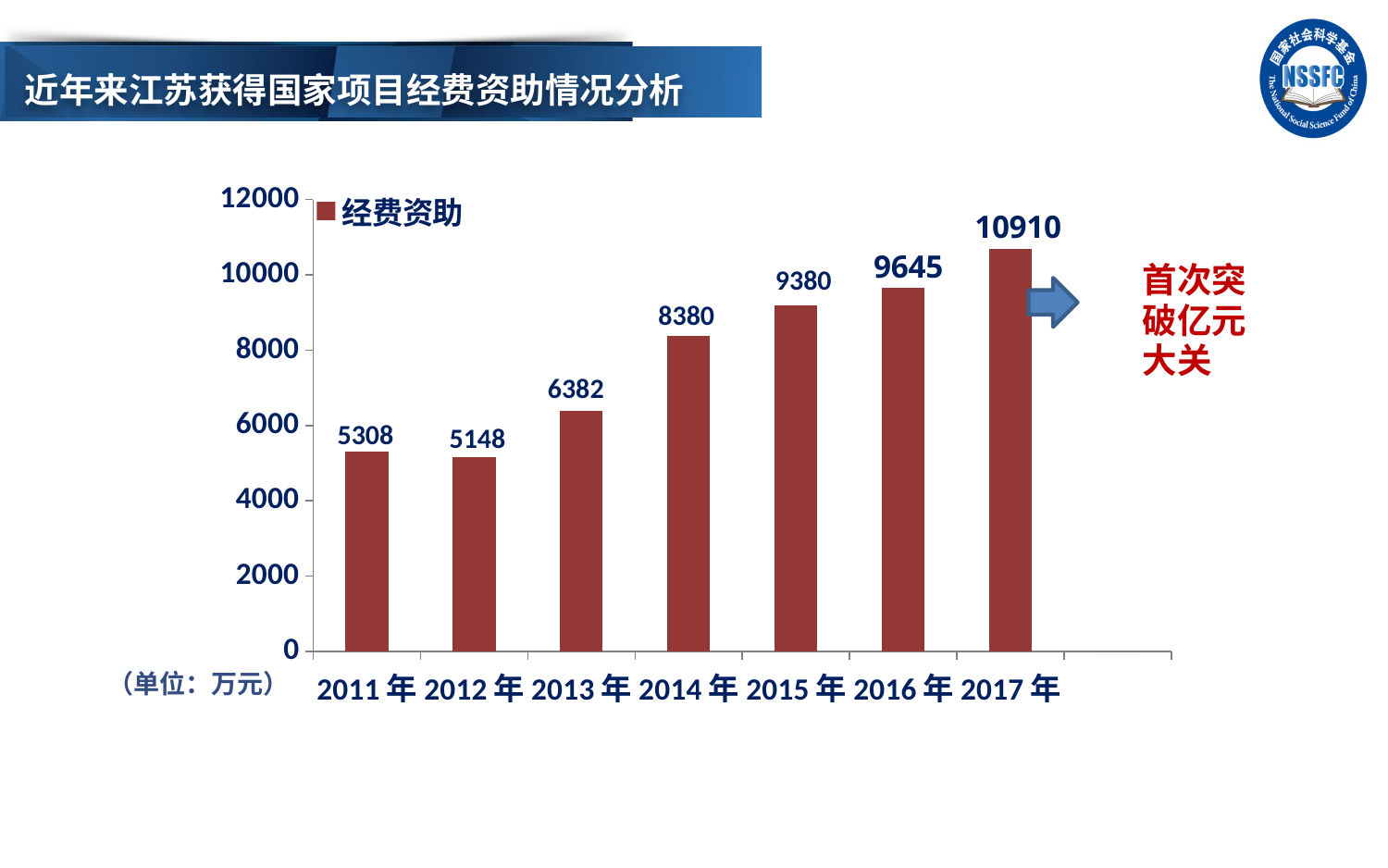
How many years are shown on the x axis? 7 Which year has the highest value? 2017年 What is the value for 2013年? 6382 Which year has the lowest value? 2012年 What is the difference between the values for 2017年 and 2016年? 1265 What is the difference between the values for 2014年 and 2013年? 1998 What series name does the legend show? 经费资助 What kind of chart is shown? bar chart What is the value for 2017年? 10910 Which is larger, the value for 2015年 or the value for 2014年? 2015年 What is the value for 2011年? 5308 Is the value for 2016年 greater or less than 8000? greater